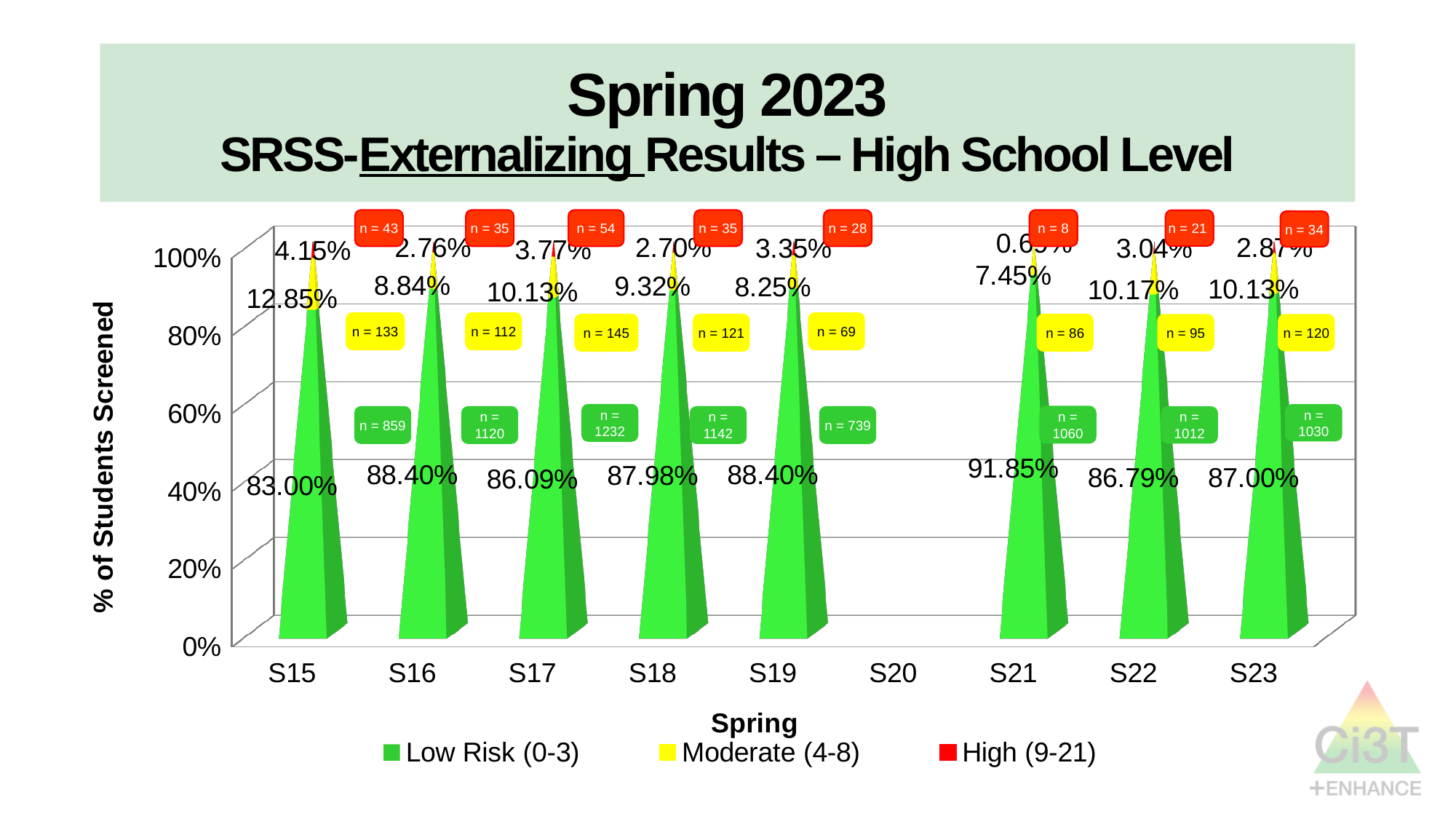
Which spring has the highest Low Risk (0-3) percentage? S21 Which spring has the highest High (9-21) percentage? S15 What is the High (9-21) percentage for S17? 3.77% What is the Moderate (4-8) percentage for S22? 10.17% Which spring has the lowest Low Risk (0-3) percentage? S15 Which has a larger Moderate (4-8) percentage, S17 or S18? S17 How many series does the legend list? 3 What is the n value shown for the Low Risk (0-3) group in S17? n = 1232 What kind of chart is shown on the slide? Stacked bar chart Which spring has the highest Moderate (4-8) percentage? S15 What is the Low Risk (0-3) percentage for S15? 83.00% How much higher is the Low Risk (0-3) percentage for S16 than for S15? 5.40 percentage points